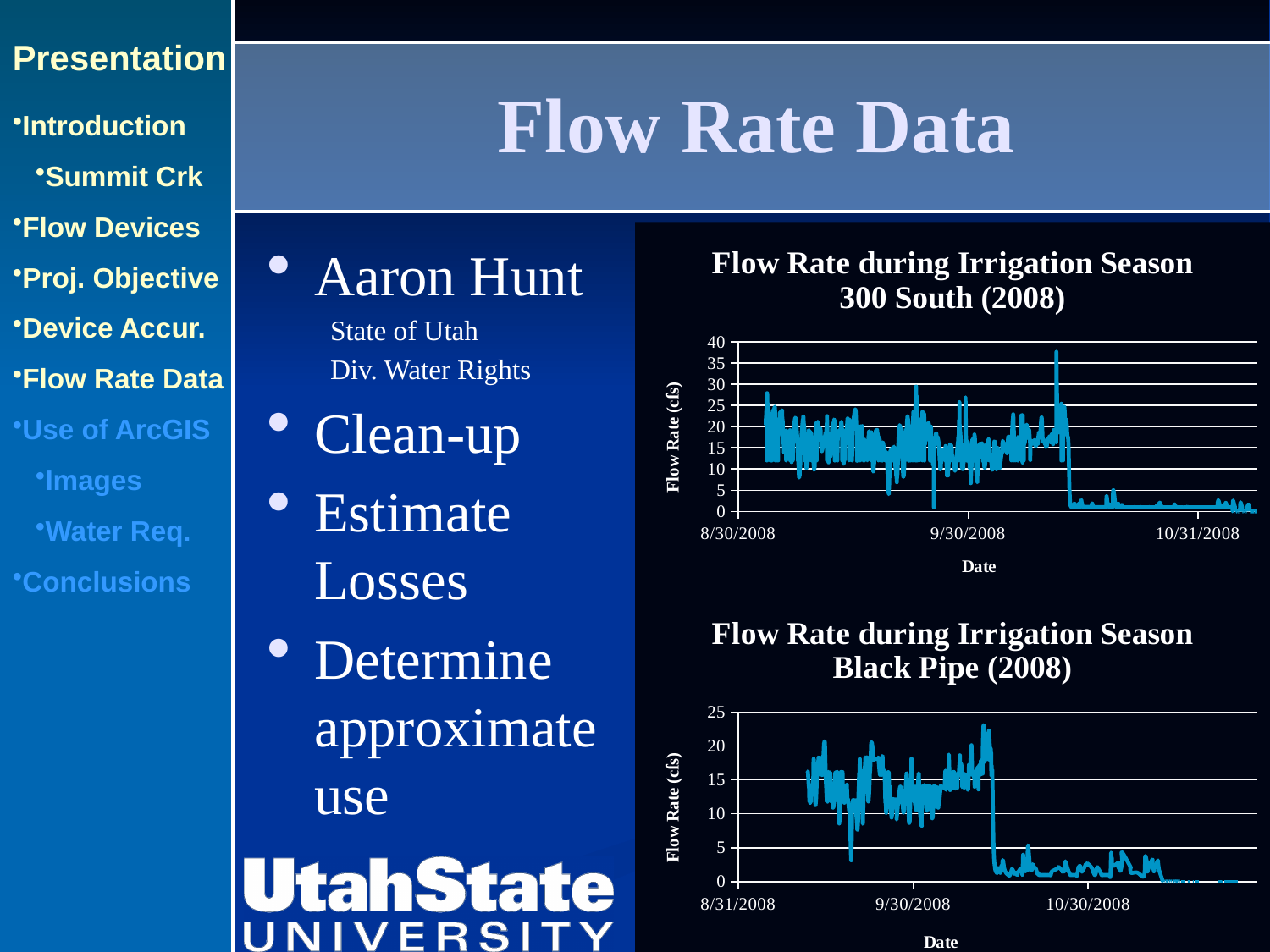
In the 300 South (2008) chart, does the flow rate generally rise or fall from September to the end of October? fall In the Black Pipe (2008) chart, does the flow rate generally rise or fall from late September to the end of October? fall What kind of chart is the 'Flow Rate during Irrigation Season 300 South (2008)' chart? line chart In the 300 South (2008) chart, what is the highest value shown on the y axis? 40 In the Black Pipe (2008) chart, what is the highest value shown on the y axis? 25 In the 300 South (2008) chart, is the flow rate around 10/31/2008 greater or less than 5 cfs? less In the 300 South (2008) chart, what is the first date shown on the x axis? 8/30/2008 How many charts are shown on the slide? 2 What kind of chart is the 'Flow Rate during Irrigation Season Black Pipe (2008)' chart? line chart In the Black Pipe (2008) chart, what is the label of the x axis? Date In the 300 South (2008) chart, what is the label of the y axis? Flow Rate (cfs) In the Black Pipe (2008) chart, is the flow rate around 9/30/2008 greater or less than 5 cfs? greater